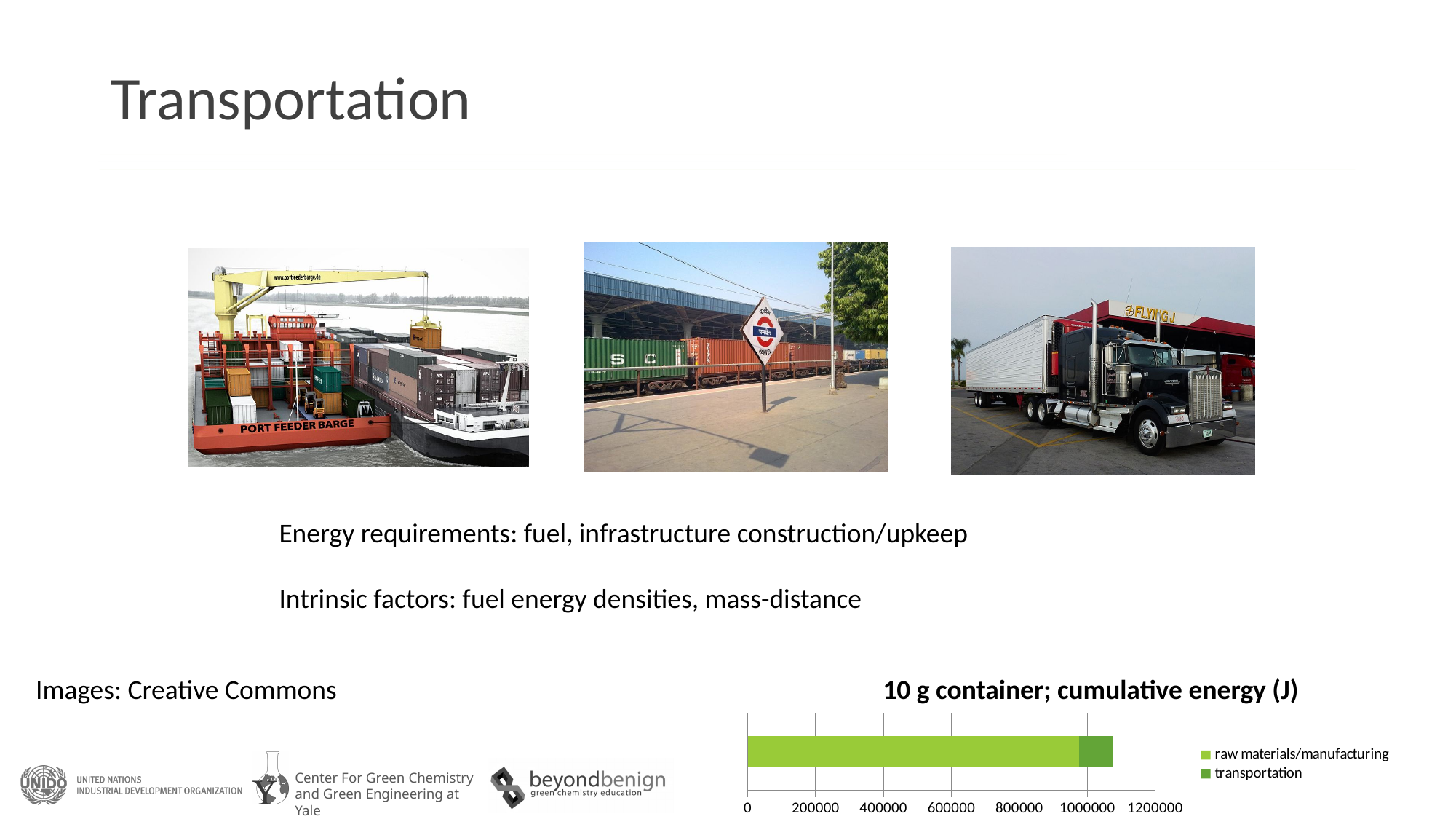
How many bars are plotted in the chart? 1 Is the value for raw materials/manufacturing greater or less than 800000? greater What is the highest value shown on the chart's x axis? 1200000 Is the total length of the stacked bar greater or less than 1000000? greater What is the title of the chart on the slide? 10 g container; cumulative energy (J) What are the two series named in the chart's legend? raw materials/manufacturing; transportation How many series does the chart's legend list? 2 Is the total length of the stacked bar greater or less than 1200000? less What kind of chart is shown at the bottom right of the slide? bar chart Which series accounts for the larger share of the bar, raw materials/manufacturing or transportation? raw materials/manufacturing